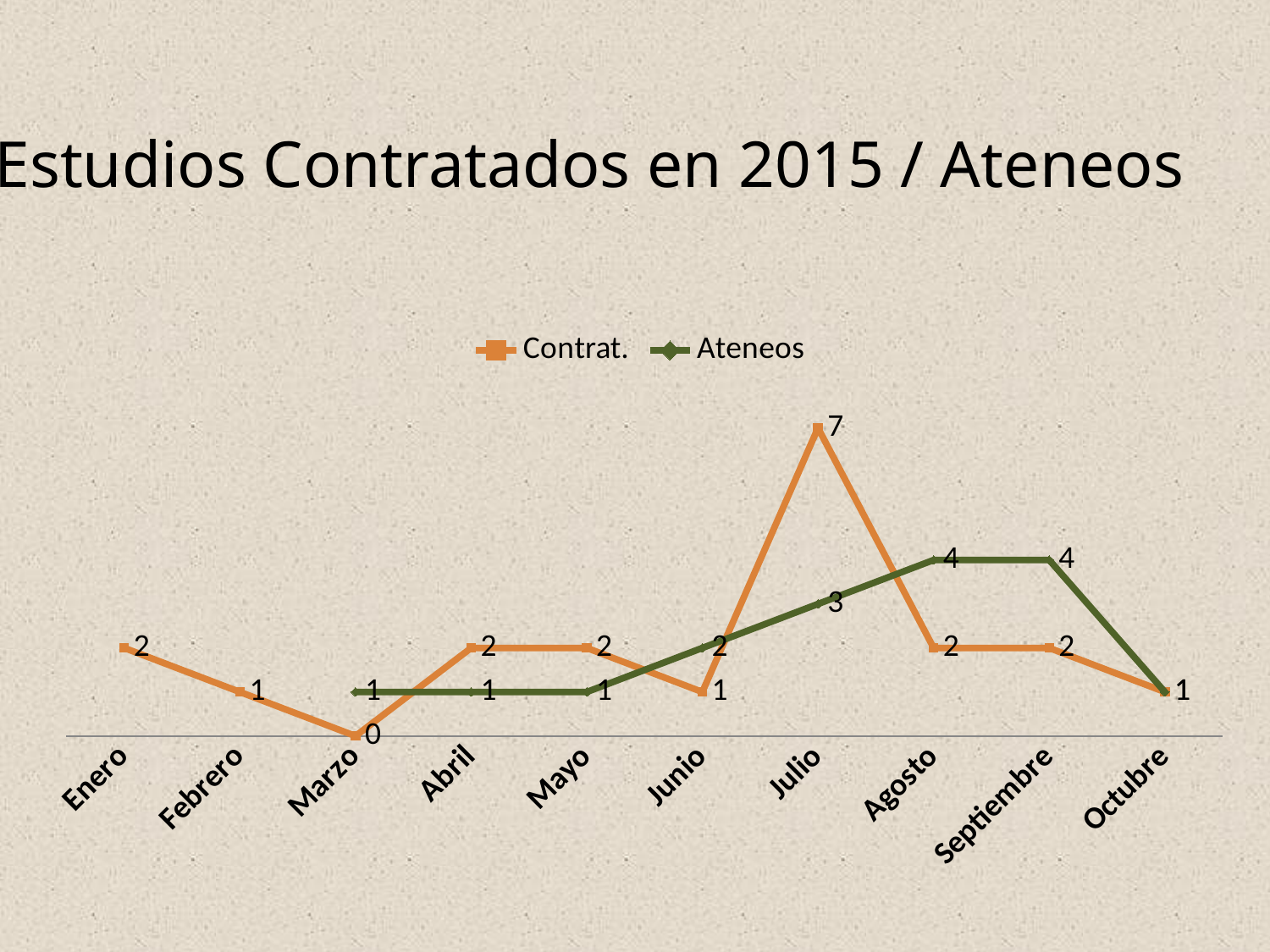
In which month does the Contrat. series have its lowest value? Marzo What is the title of the chart? Estudios Contratados en 2015 / Ateneos What kind of chart is shown on the slide? Line chart Does the Ateneos series rise or fall from Marzo to Agosto? Rise What is the value of the Contrat. series in Marzo? 0 How many months are shown on the x axis? 10 In Julio, how much higher is the Contrat. value than the Ateneos value? 4 What is the value of the Ateneos series in Agosto? 4 What is the value of the Contrat. series in Julio? 7 In Agosto, which series has the larger value, Contrat. or Ateneos? Ateneos In which month does the Contrat. series reach its highest value? Julio How many series does the legend list? 2